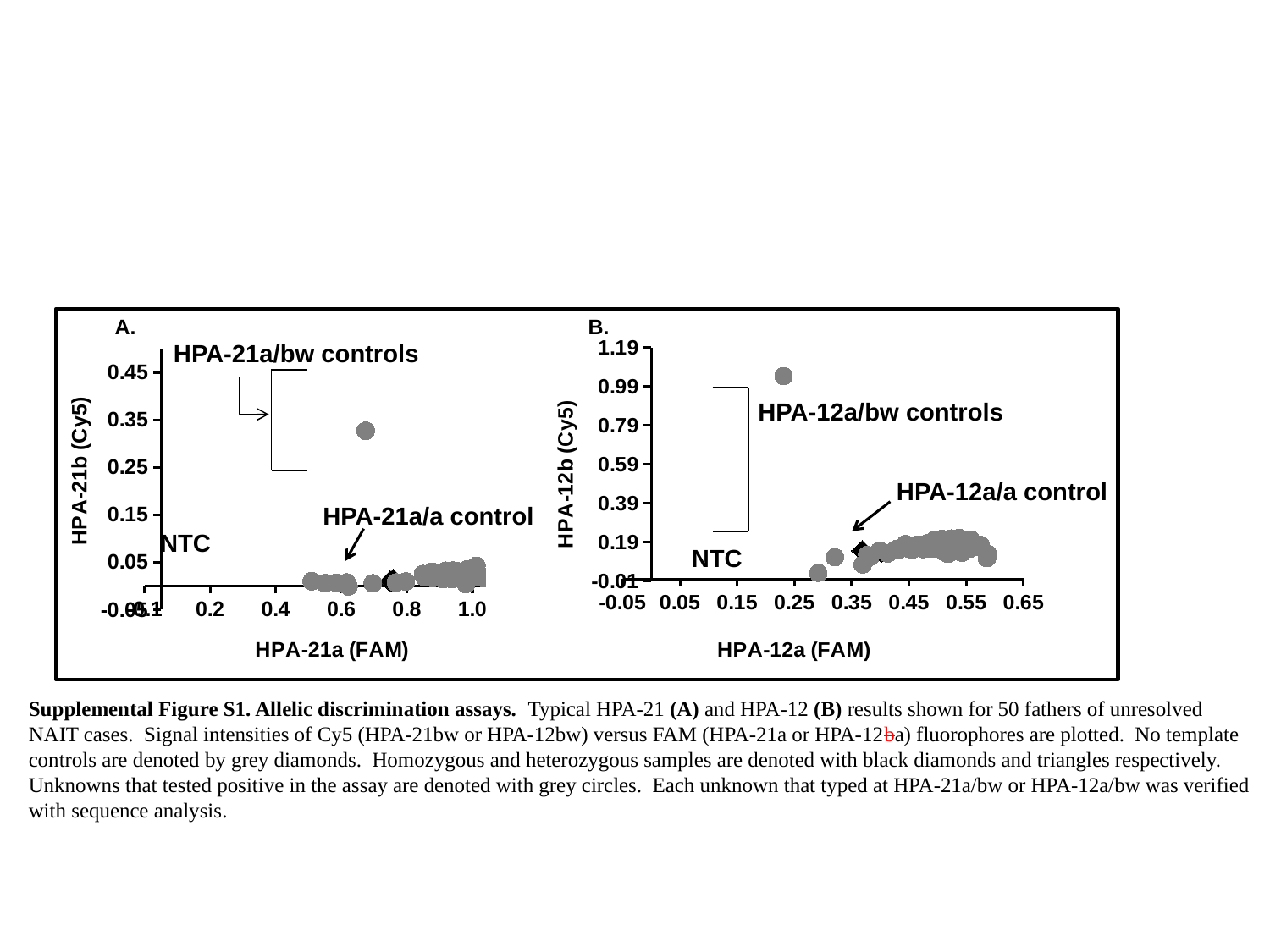
In chart B, is the HPA-12a (FAM) value of the highest grey circle greater or less than 0.35? less In chart A, which has the higher HPA-21b (Cy5) value: the isolated grey circle near the HPA-21a/bw controls bracket or the cluster of grey circles near the HPA-21a/a control? the isolated grey circle near the HPA-21a/bw controls bracket In chart A, is the HPA-21a (FAM) value of the isolated grey circle near the HPA-21a/bw controls bracket greater or less than 0.8? less What kind of chart is chart B (HPA-12)? scatter chart What kind of chart is chart A (HPA-21)? scatter chart In chart B, which has the higher HPA-12b (Cy5) value: the isolated grey circle near the HPA-12a/bw controls bracket or the cluster of grey circles near the HPA-12a/a control? the isolated grey circle near the HPA-12a/bw controls bracket In chart B, what is the label of the y axis? HPA-12b (Cy5) In chart B, is the HPA-12b (Cy5) value of the highest grey circle greater or less than 0.79? greater In chart A, what is the label of the x axis? HPA-21a (FAM)